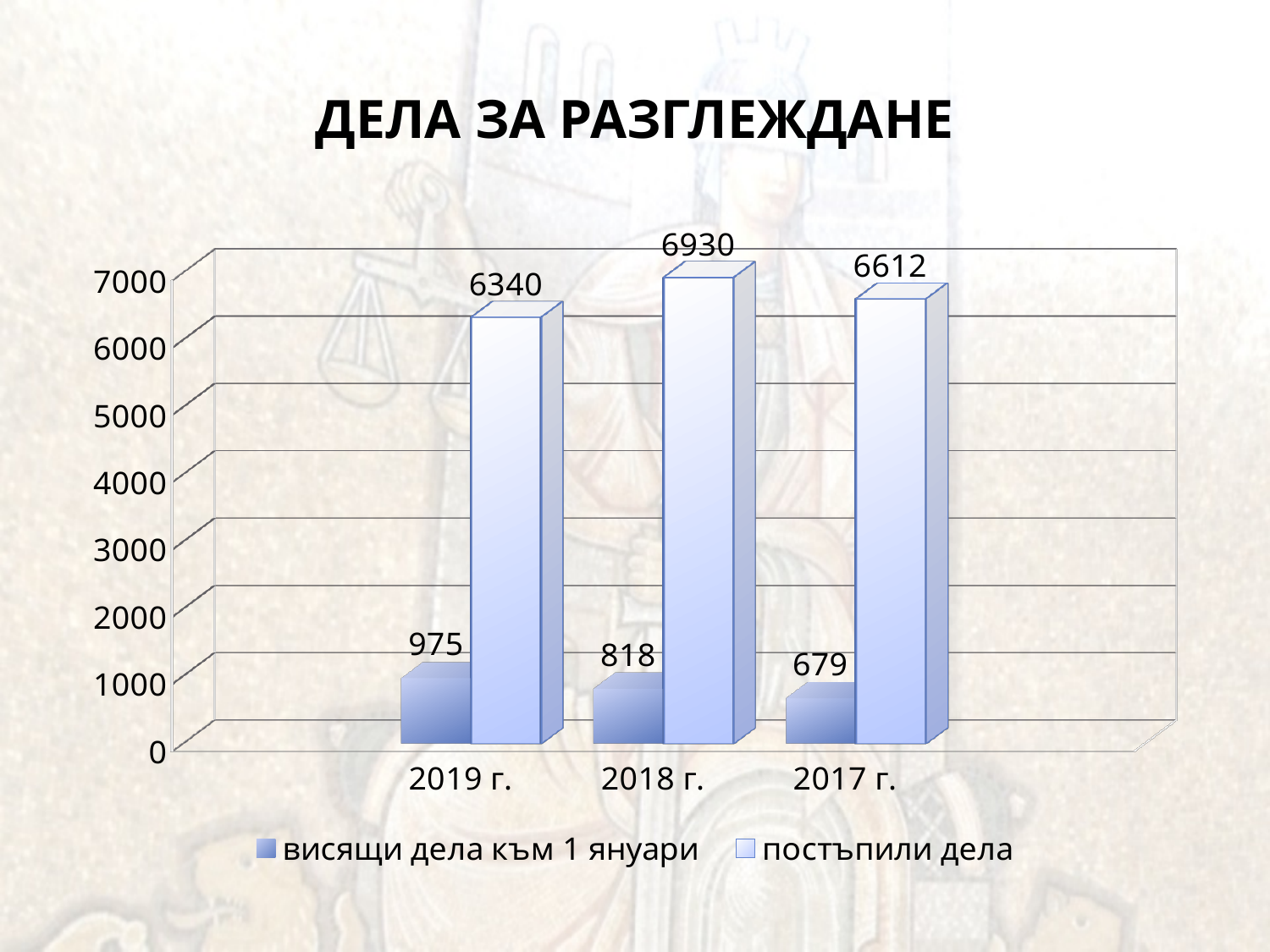
Which is larger: "постъпили дела" in 2019 г. or in 2017 г.? 2017 г. How many years are shown on the x axis? 3 What is the difference between "постъпили дела" in 2018 г. and 2017 г.? 318 What kind of chart is shown on the slide? bar chart How many series does the legend list? 2 Which year has the lowest value for "висящи дела към 1 януари"? 2017 г. What is the title of the chart? ДЕЛА ЗА РАЗГЛЕЖДАНЕ What is the value of "постъпили дела" for 2019 г.? 6340 Which year has the highest value for "постъпили дела"? 2018 г. What is the value of "висящи дела към 1 януари" for 2017 г.? 679 What is the difference between "висящи дела към 1 януари" in 2019 г. and 2018 г.? 157 What is the value of "висящи дела към 1 януари" for 2018 г.? 818